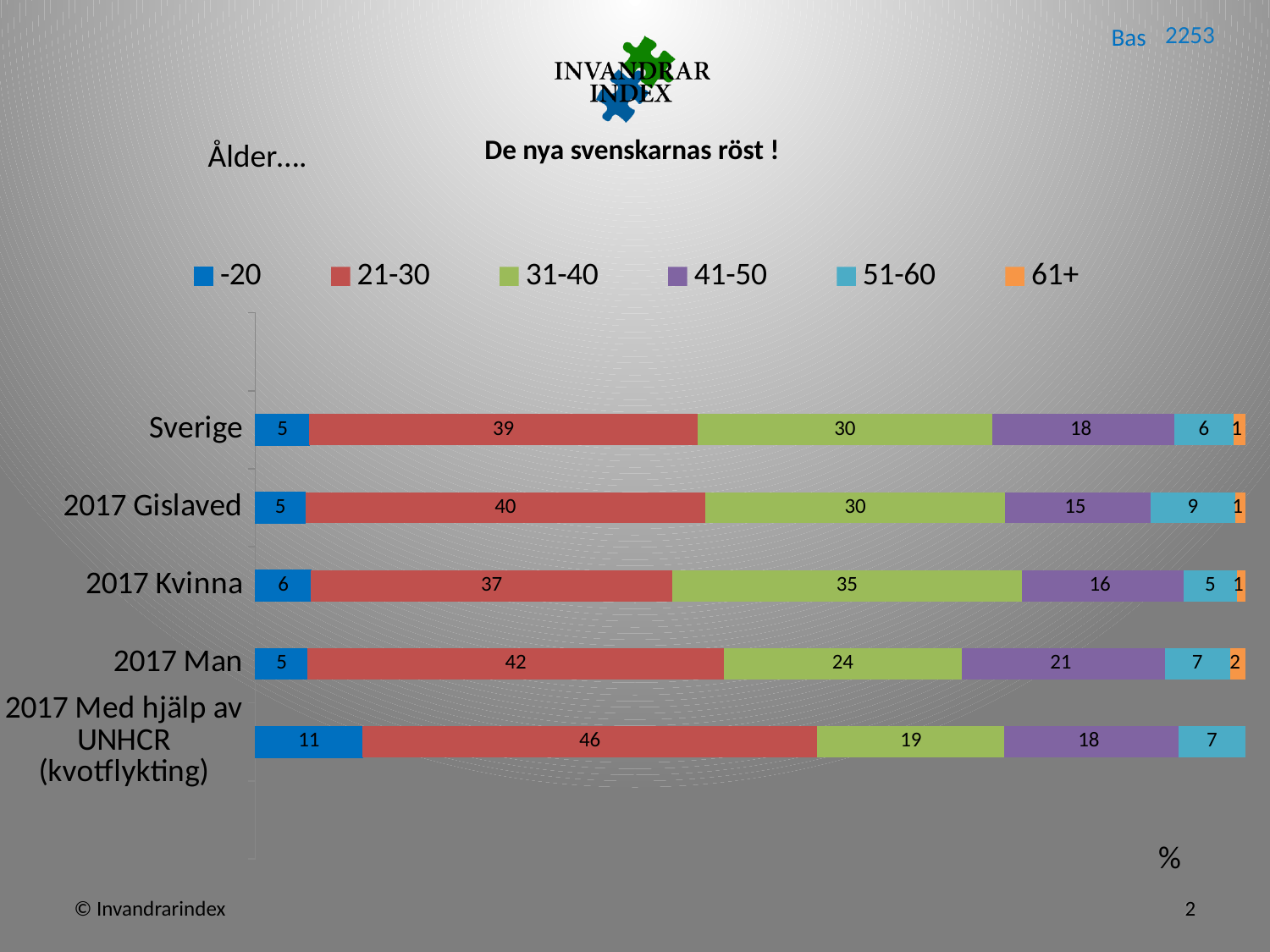
What is the value for the 21-30 series in the 2017 Man bar? 42 What is the total of the Sverige stacked bar? 99 Which category has the lowest value for the 31-40 series? 2017 Med hjälp av UNHCR (kvotflykting) What is the value for the 31-40 series in the 2017 Kvinna bar? 35 How many categories (bars) are shown in the chart? 5 What is the difference between the 41-50 values for 2017 Man and 2017 Gislaved? 6 Which category has the highest value for the 21-30 series? 2017 Med hjälp av UNHCR (kvotflykting) What is the value for the -20 series in the 2017 Med hjälp av UNHCR (kvotflykting) bar? 11 What is the value for the 51-60 series in the 2017 Gislaved bar? 9 How many series does the legend list? 6 Which is larger: the 31-40 value for 2017 Kvinna or for 2017 Man? 2017 Kvinna What kind of chart is shown on the slide? stacked bar chart